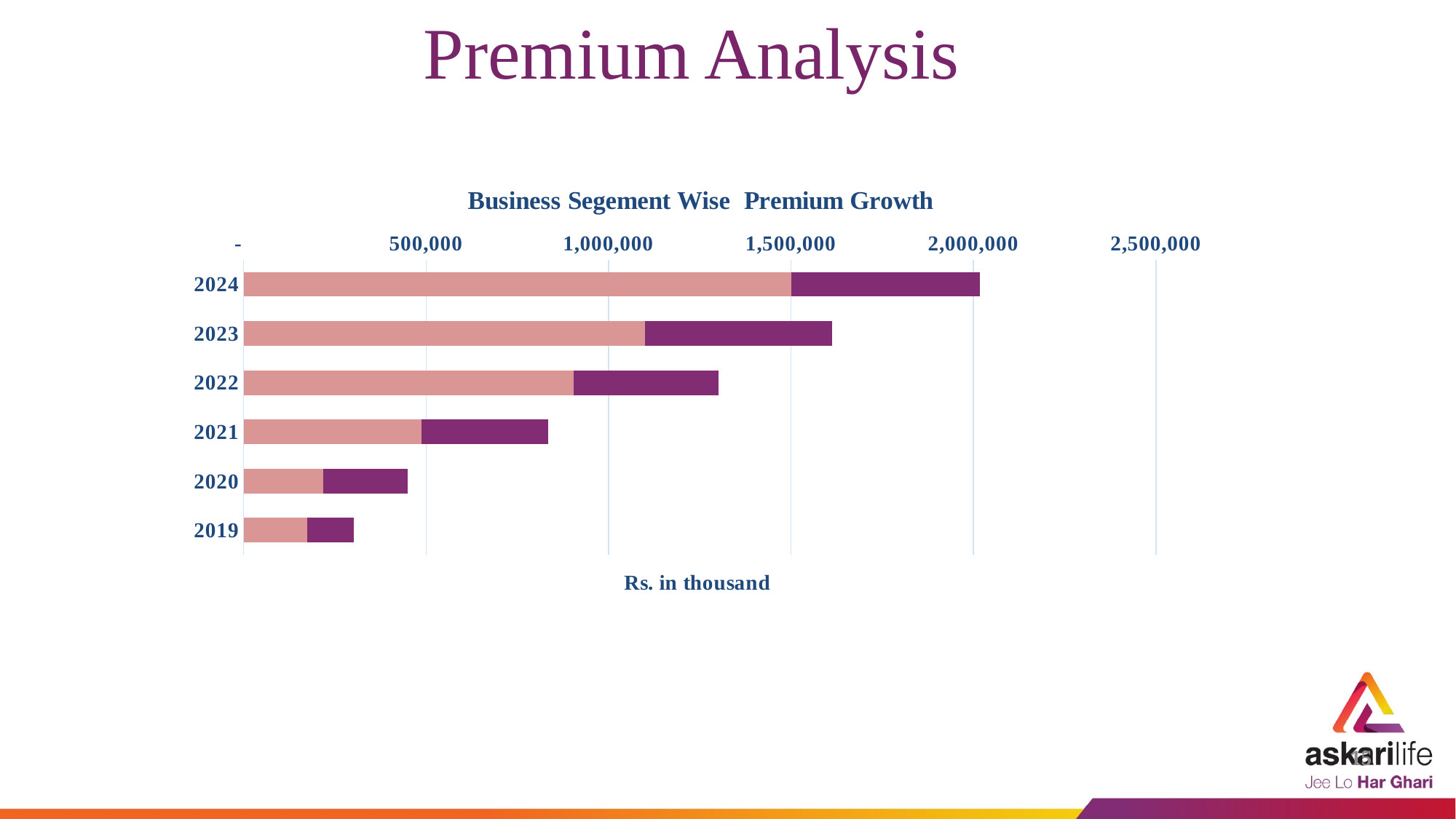
Which year has the larger total bar, 2022 or 2021? 2022 What unit is stated below the chart's axis? Rs. in thousand What is the title of the chart? Business Segement Wise Premium Growth Do the total premium values rise or fall from 2019 to 2024? Rise How many years are shown on the chart? 6 Is the total bar for 2023 greater or less than 1,500,000? greater Which year has the shortest total bar? 2019 Is the light pink segment for 2023 greater or less than 1,000,000? greater Is the total bar for 2020 greater or less than 500,000? less Which year has the longest total bar? 2024 What kind of chart is shown on the slide? Stacked bar chart